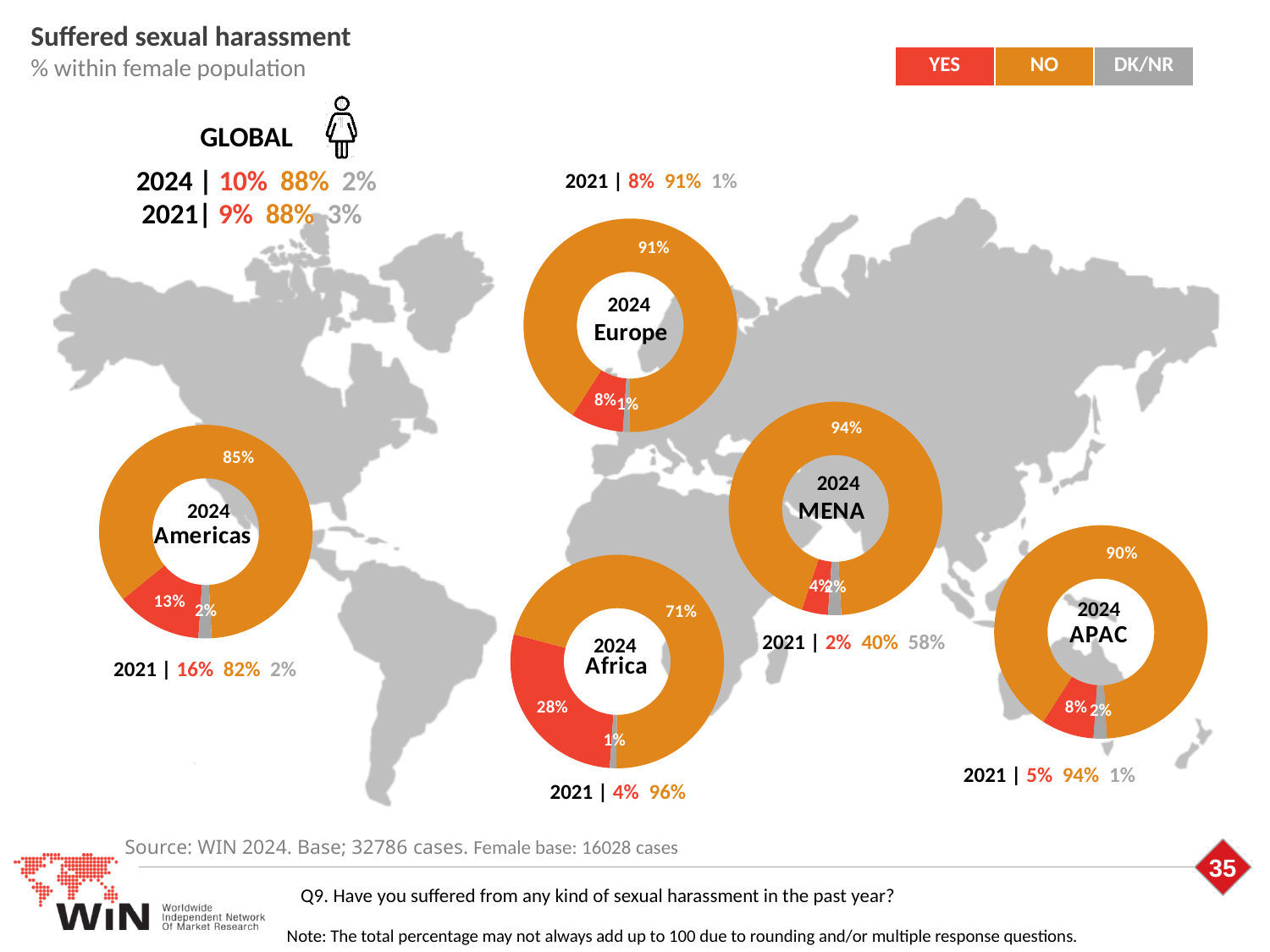
In the 2024 APAC donut chart, what percentage answered NO? 90% How many response categories does the legend list? 3 Which is larger: the NO percentage in the 2024 MENA chart or the NO percentage in the 2024 Europe chart? MENA Which colour represents the YES response in the legend? Red In the 2024 Africa donut chart, what percentage answered YES? 28% Which region's 2024 donut chart shows the lowest YES percentage? MENA Which region's 2024 donut chart shows the highest YES percentage? Africa How many regional donut charts are shown on the slide? 5 In the 2024 Europe donut chart, what percentage answered NO? 91% What is the difference between the YES percentage in the 2024 Africa chart and the YES percentage in the 2024 Americas chart? 15 percentage points What type of chart is used to show the 2024 regional results? Donut (pie) chart In the 2024 Americas donut chart, what percentage answered YES? 13%